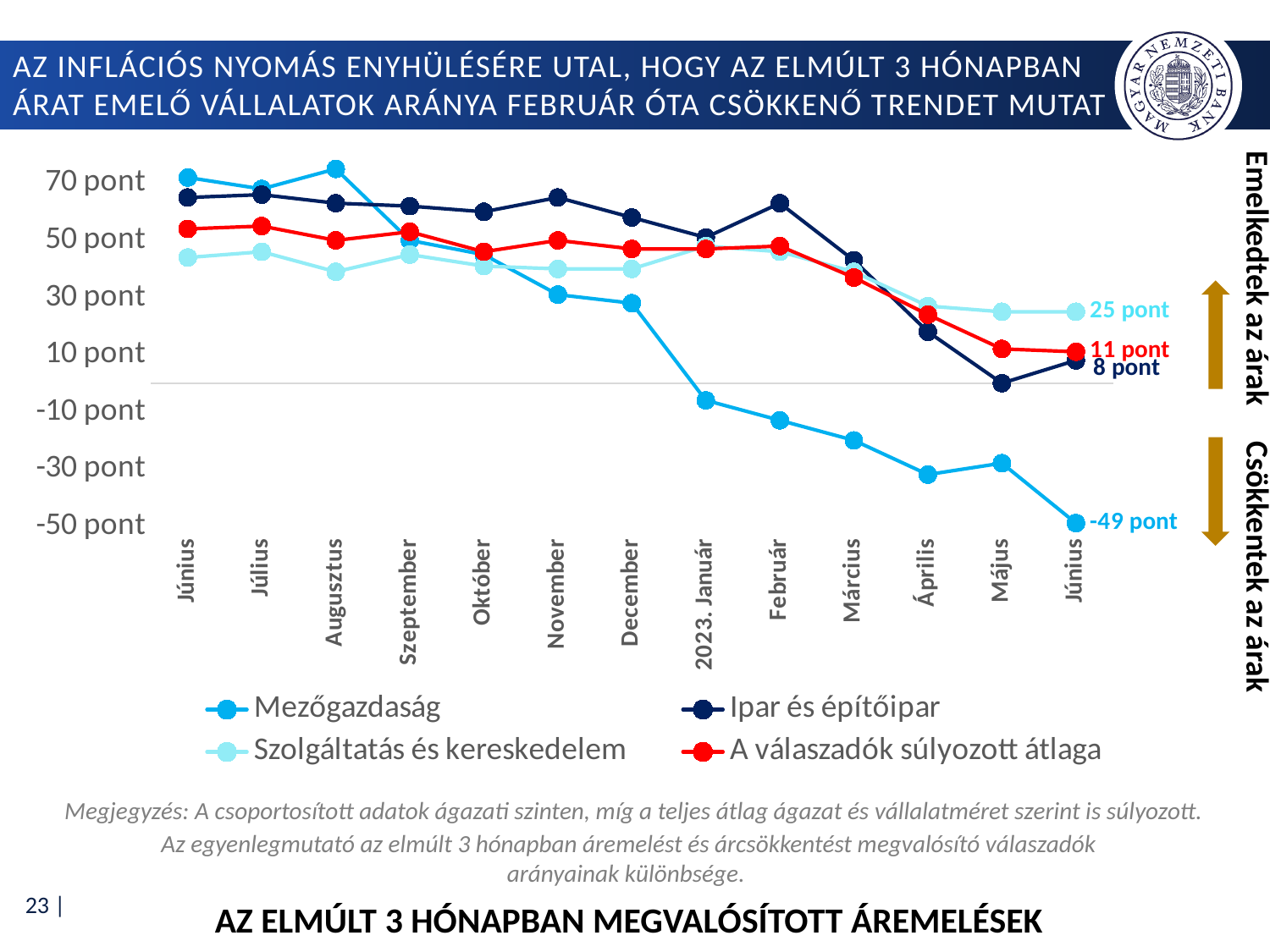
What is the value for Ipar és építőipar at the final Június (2023) point? 8 pont Is the value for Mezőgazdaság at the first Június greater or less than 50 pont? greater At the final Június (2023) point, which is higher: Szolgáltatás és kereskedelem or Ipar és építőipar? Szolgáltatás és kereskedelem What is the difference between the final values of Szolgáltatás és kereskedelem (25 pont) and Mezőgazdaság (-49 pont)? 74 pont Which series has the lowest value at the final Június (2023) point? Mezőgazdaság How many series does the legend list? 4 What is the value for Szolgáltatás és kereskedelem at the final Június (2023) point? 25 pont What kind of chart is shown on the slide? line chart How many months are shown on the x axis? 13 Does the Mezőgazdaság series rise or fall from the first Június to the last Június? fall What is the value for Mezőgazdaság at the final Június (2023) point? -49 pont What is the value for A válaszadók súlyozott átlaga at the final Június (2023) point? 11 pont